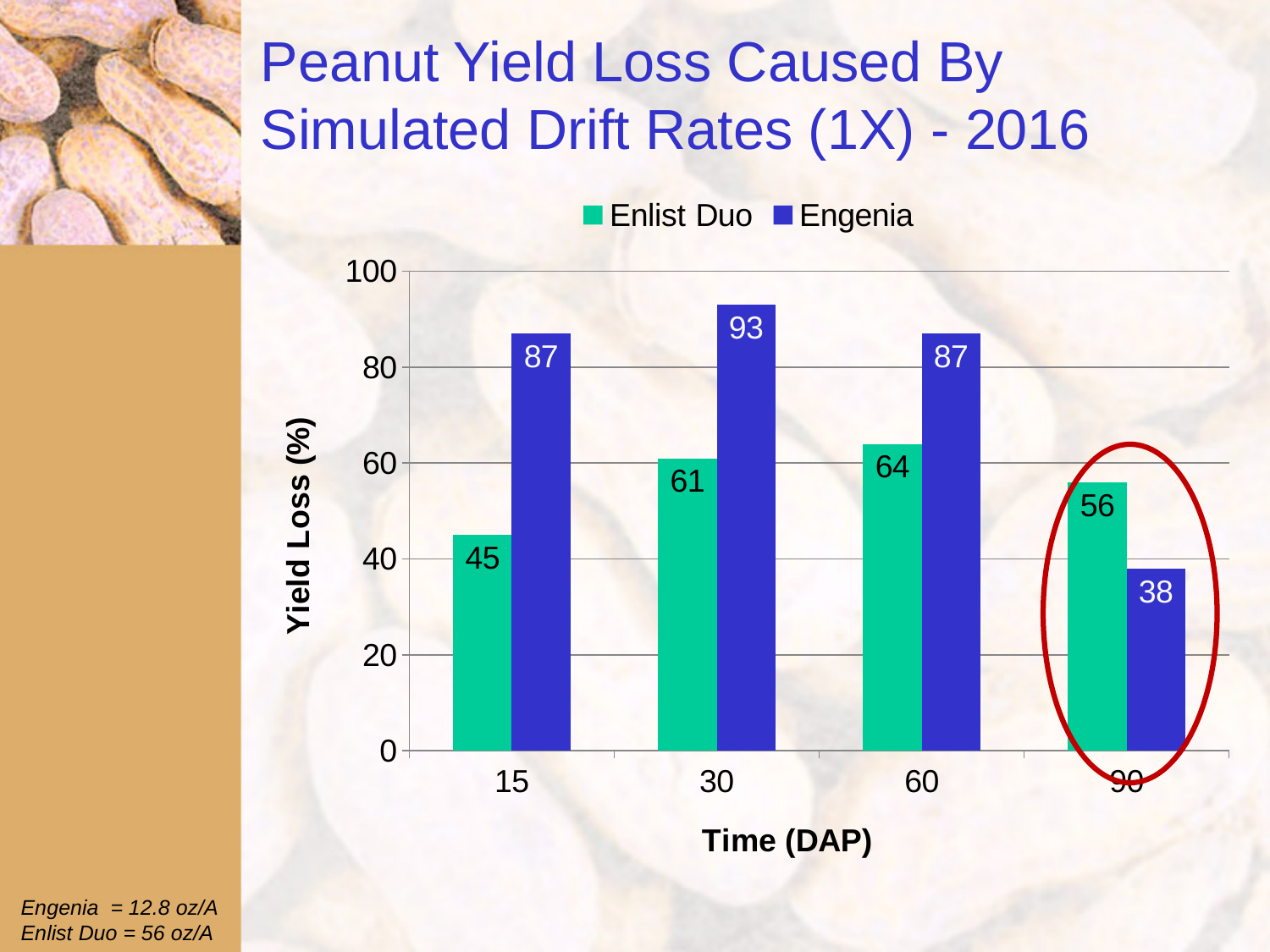
Which series is shown in blue? Engenia What kind of chart is shown on the slide? Bar chart What is the label of the y axis? Yield Loss (%) At which time (DAP) is the Enlist Duo yield loss lowest? 15 How many series does the legend list? 2 What is the yield loss for Enlist Duo at 15 DAP? 45 At which time (DAP) is the Engenia yield loss highest? 30 What is the yield loss for Engenia at 30 DAP? 93 What is the yield loss for Engenia at 90 DAP? 38 What is the difference between the Engenia and Enlist Duo yield loss at 15 DAP? 42 At 90 DAP, which series has the larger yield loss, Enlist Duo or Engenia? Enlist Duo How many time points (DAP) are shown on the x axis? 4